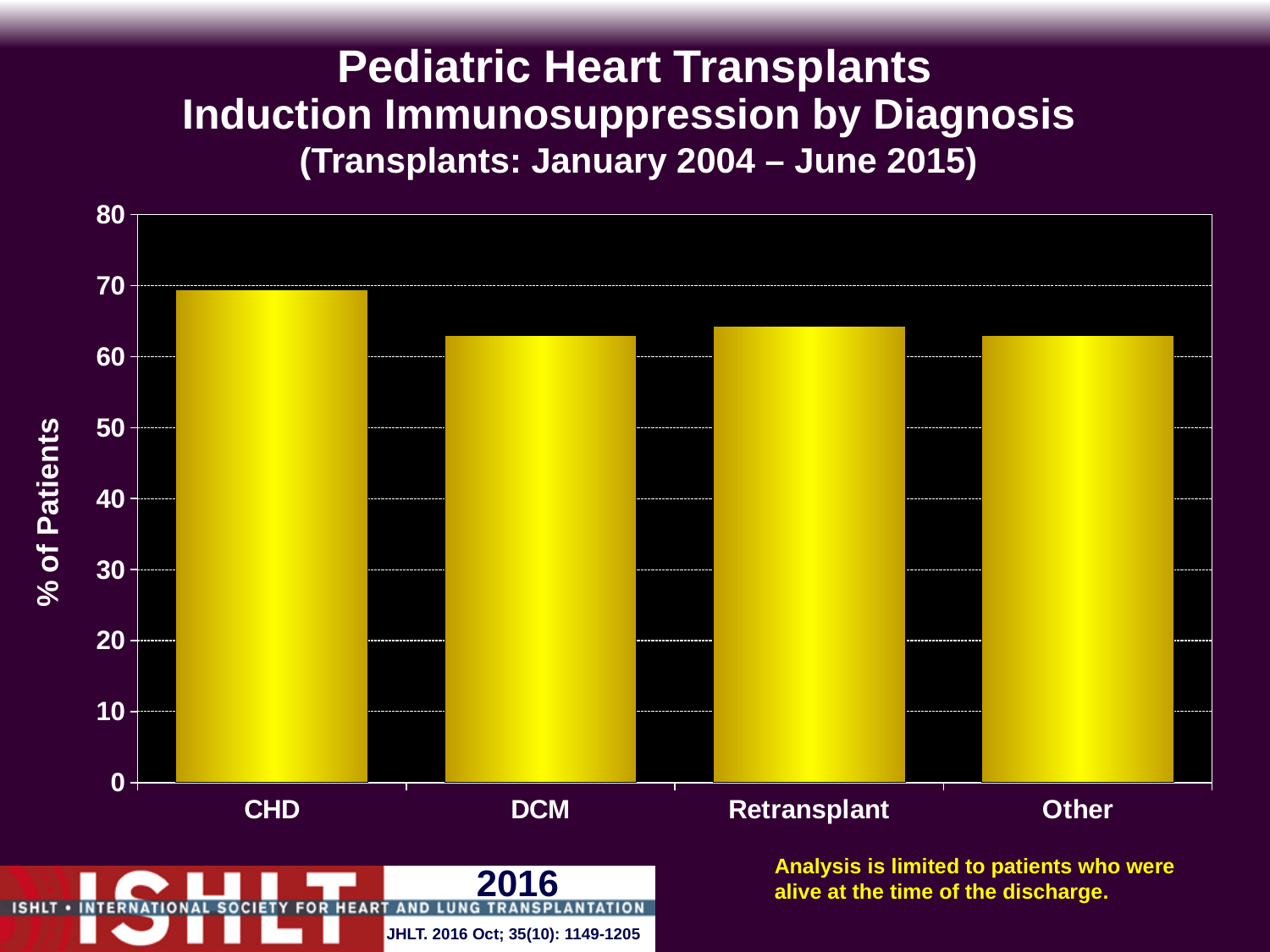
Which is larger, the value for CHD or the value for Other? CHD Which is larger, the value for CHD or the value for DCM? CHD Is the value for Retransplant greater or less than 70? less Which diagnosis category has the highest percentage of patients? CHD How many diagnosis categories are shown on the x axis? 4 Is the value for CHD greater or less than 60? greater Is the value for DCM greater or less than 60? greater What is the label of the y axis? % of Patients What kind of chart is shown on the slide? bar chart What time period of transplants does the chart title say it covers? January 2004 – June 2015